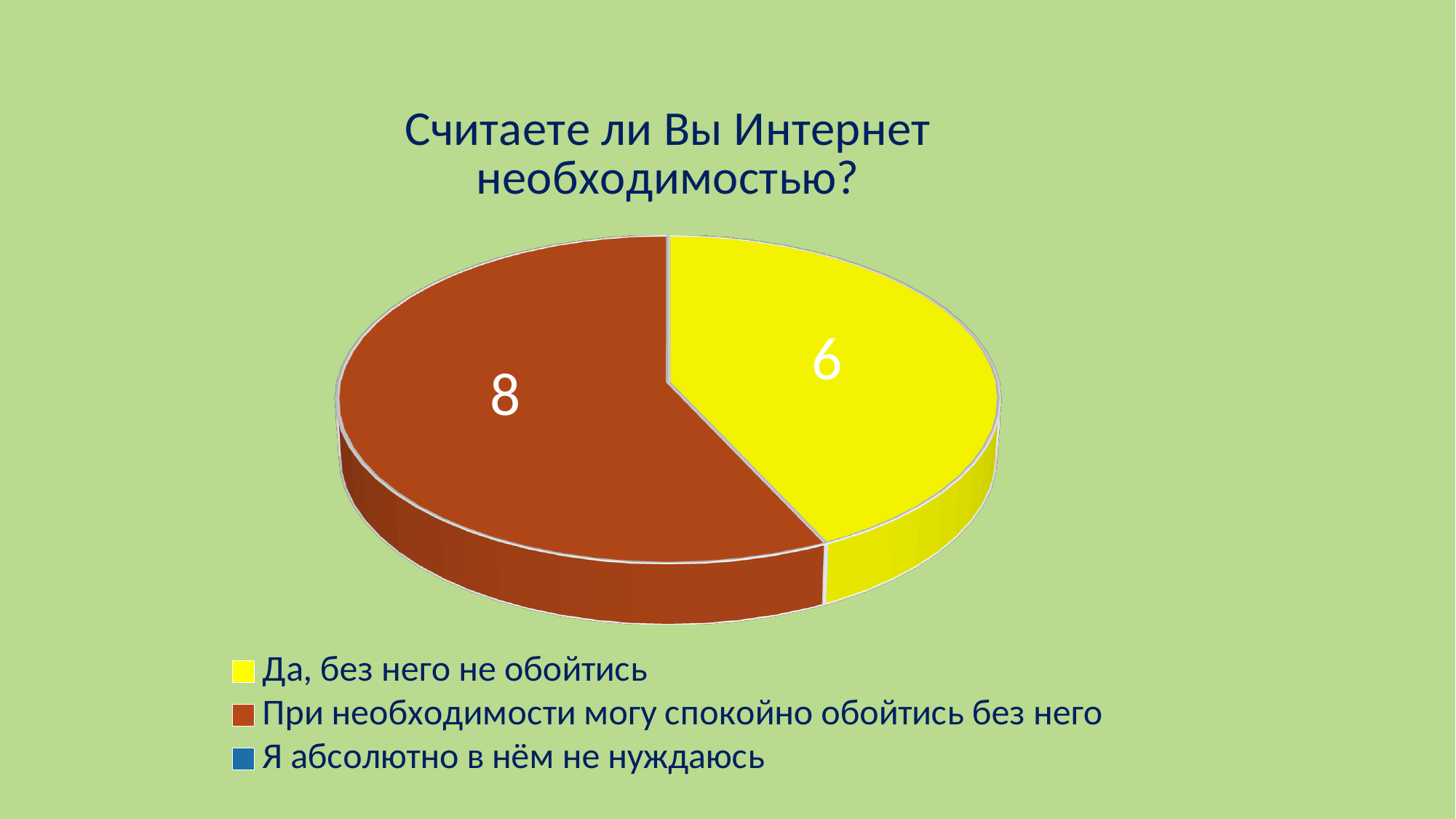
How many entries does the legend list? 3 Which of the two labelled slices is smaller? Да, без него не обойтись What type of chart is shown on the slide? pie chart What is the value for "Да, без него не обойтись"? 6 Which category has the largest slice? При необходимости могу спокойно обойтись без него What is the value for "При необходимости могу спокойно обойтись без него"? 8 What colour is the slice for "Да, без него не обойтись"? yellow Which is larger: the value for "Да, без него не обойтись" or for "При необходимости могу спокойно обойтись без него"? При необходимости могу спокойно обойтись без него What is the total of the two labelled slices? 14 What is the title of the chart? Считаете ли Вы Интернет необходимостью? What is the difference between the values for "При необходимости могу спокойно обойтись без него" and "Да, без него не обойтись"? 2